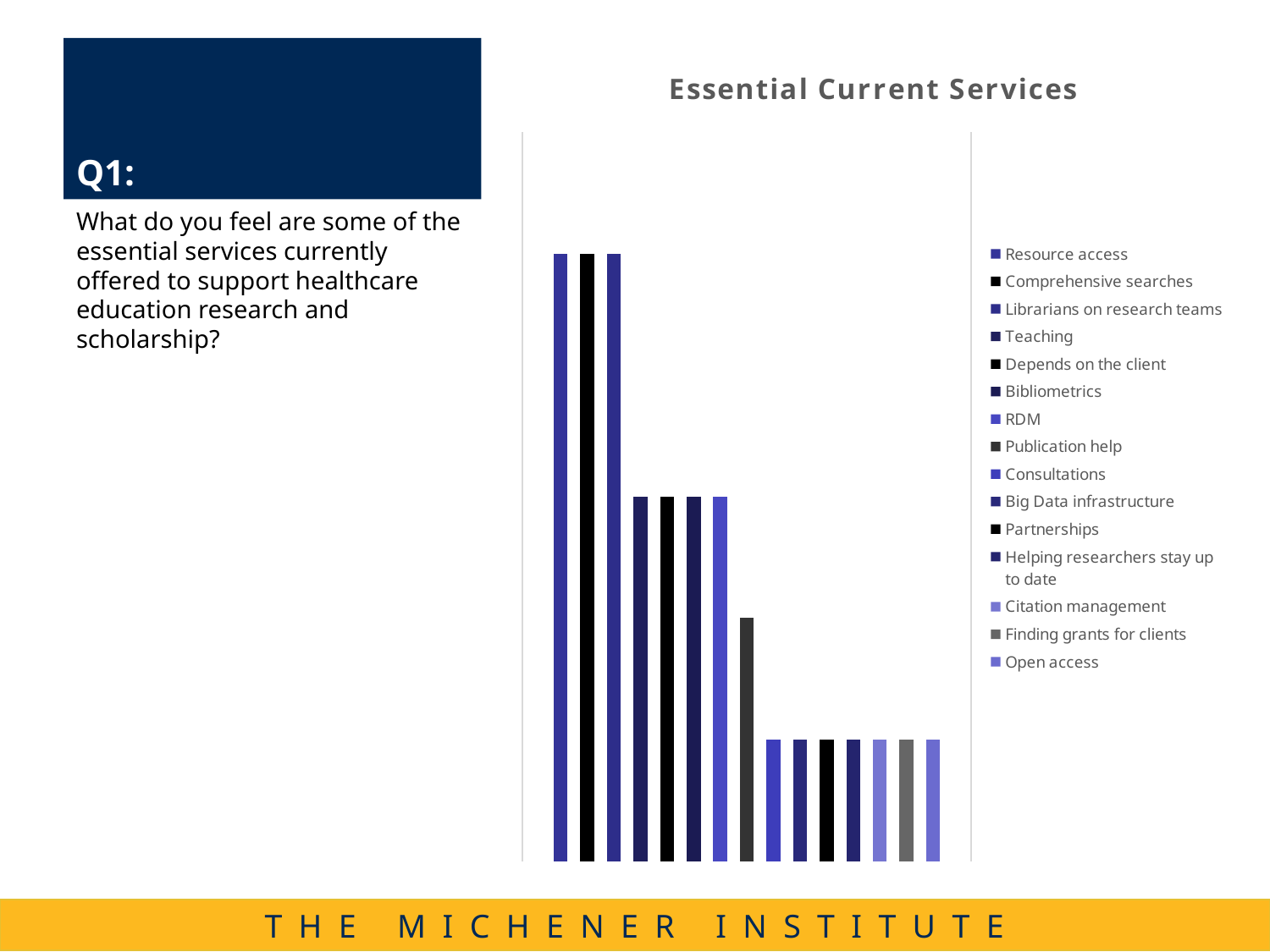
Which is larger in the 'Essential Current Services' chart: Teaching or Publication help? Teaching What is the first entry listed in the legend of the 'Essential Current Services' chart? Resource access How many series does the legend of the 'Essential Current Services' chart list? 15 Which is larger in the 'Essential Current Services' chart: Publication help or Citation management? Publication help How many bars are plotted in the 'Essential Current Services' chart? 15 Which is larger in the 'Essential Current Services' chart: Bibliometrics or Finding grants for clients? Bibliometrics Do the bar heights in the 'Essential Current Services' chart rise or fall from left to right? Fall What is the title of the chart on the slide? Essential Current Services What kind of chart is shown under the title 'Essential Current Services'? Bar chart